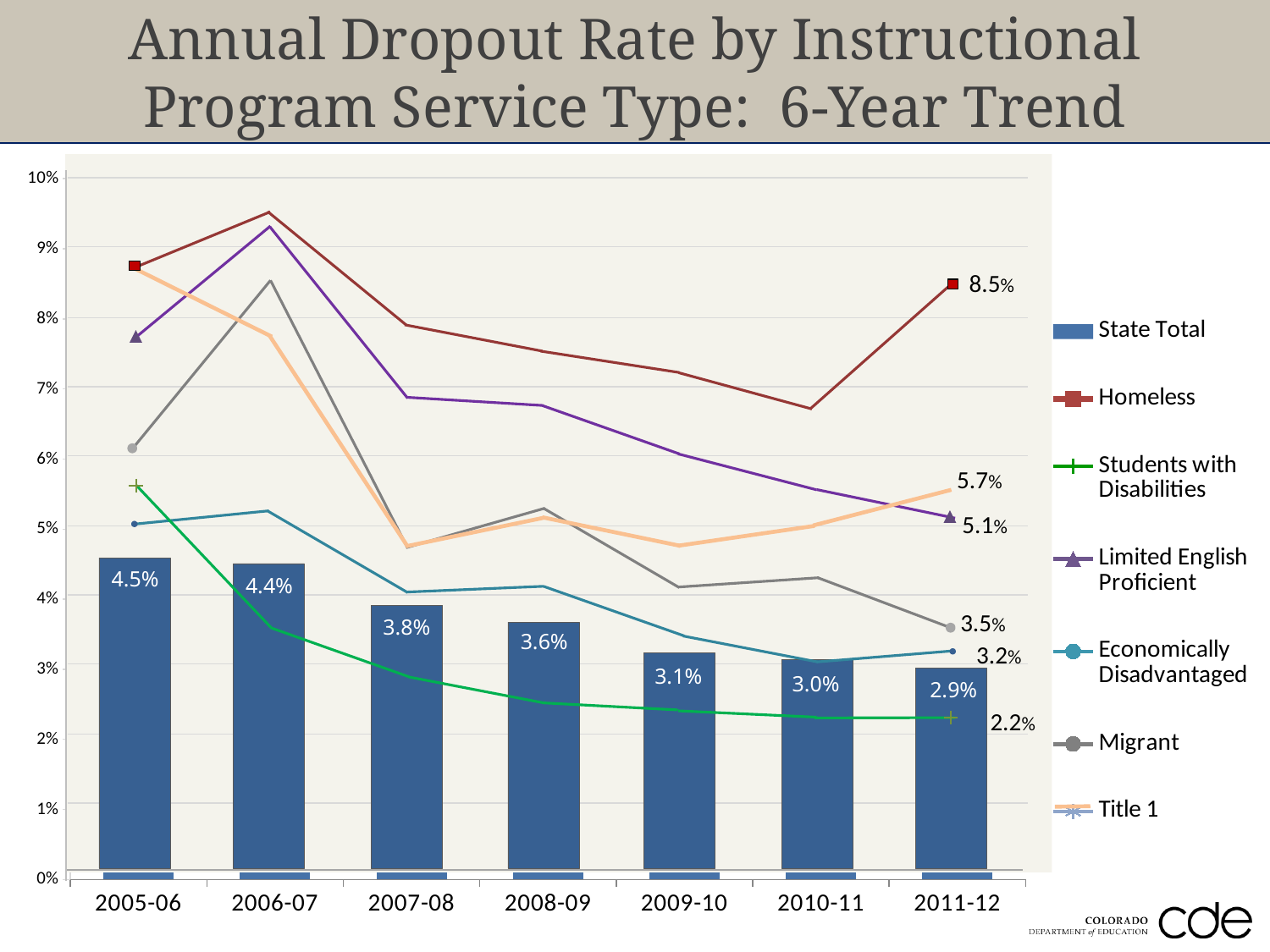
How many school years are shown on the x axis? 7 Which year has the highest State Total dropout rate? 2005-06 How many series does the legend list? 7 Does the State Total dropout rate rise or fall from 2005-06 to 2011-12? fall Is the Homeless dropout rate in 2010-11 greater or less than 6%? greater What is the State Total dropout rate for 2005-06? 4.5% In 2011-12, which group has a higher dropout rate: Title 1 or Limited English Proficient? Title 1 What is the difference between the State Total dropout rate in 2005-06 and in 2011-12? 1.6% What is the State Total dropout rate for 2011-12? 2.9% What is the Students with Disabilities dropout rate in 2011-12? 2.2% Which year has the lowest State Total dropout rate? 2011-12 What is the Homeless dropout rate in 2011-12? 8.5%